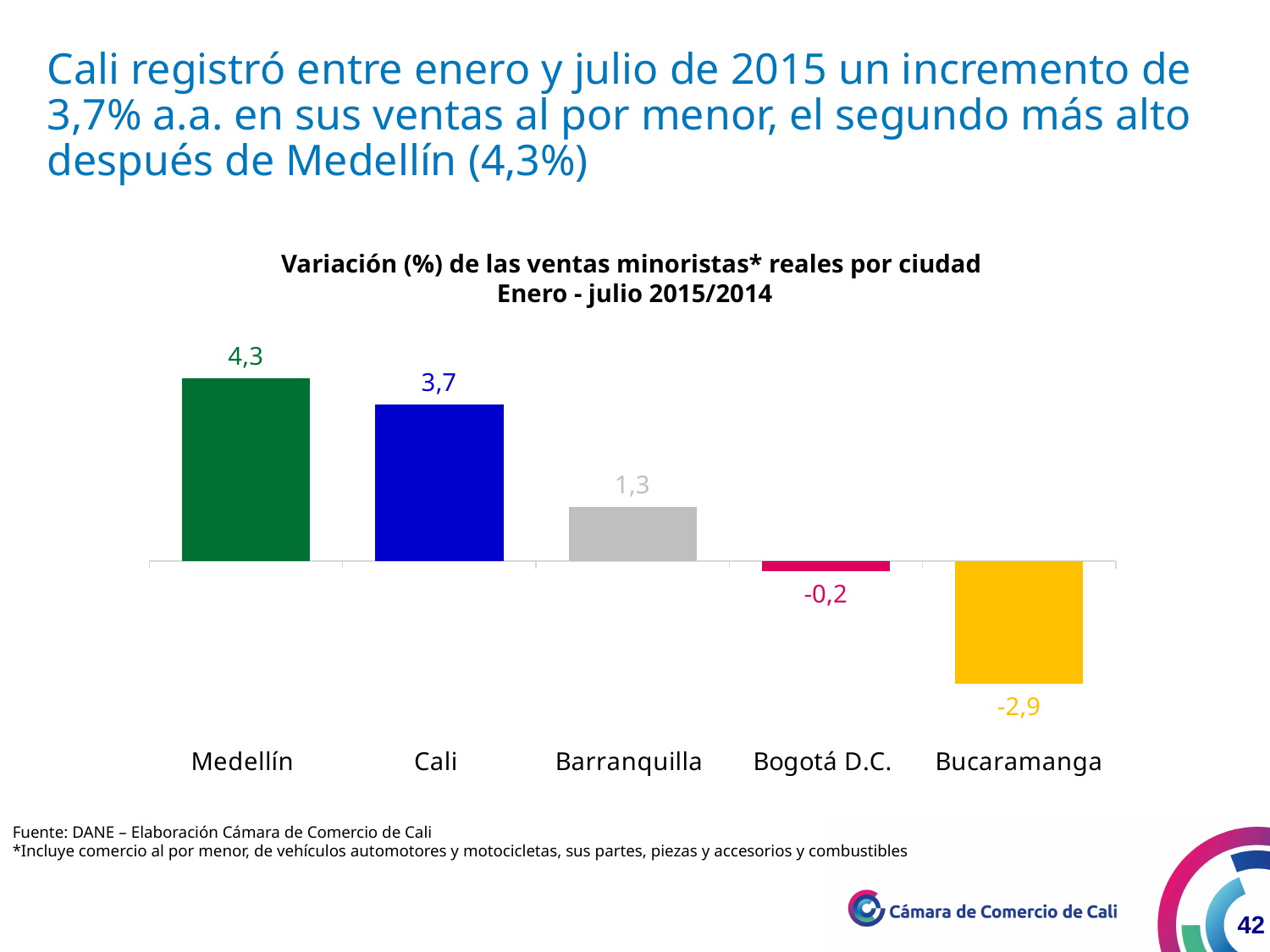
How many cities are shown in the chart? 5 What is the value for Bogotá D.C.? -0,2 What is the value for Barranquilla? 1,3 Which is larger, the value for Barranquilla or the value for Cali? Cali Which city has the highest value? Medellín What is the value for Bucaramanga? -2,9 What is the value for Cali? 3,7 What is the difference between the values for Medellín and Cali? 0,6 What is the title of the chart? Variación (%) de las ventas minoristas* reales por ciudad Enero - julio 2015/2014 Which city has the lowest value? Bucaramanga What kind of chart is shown on the slide? Bar chart What is the value for Medellín? 4,3